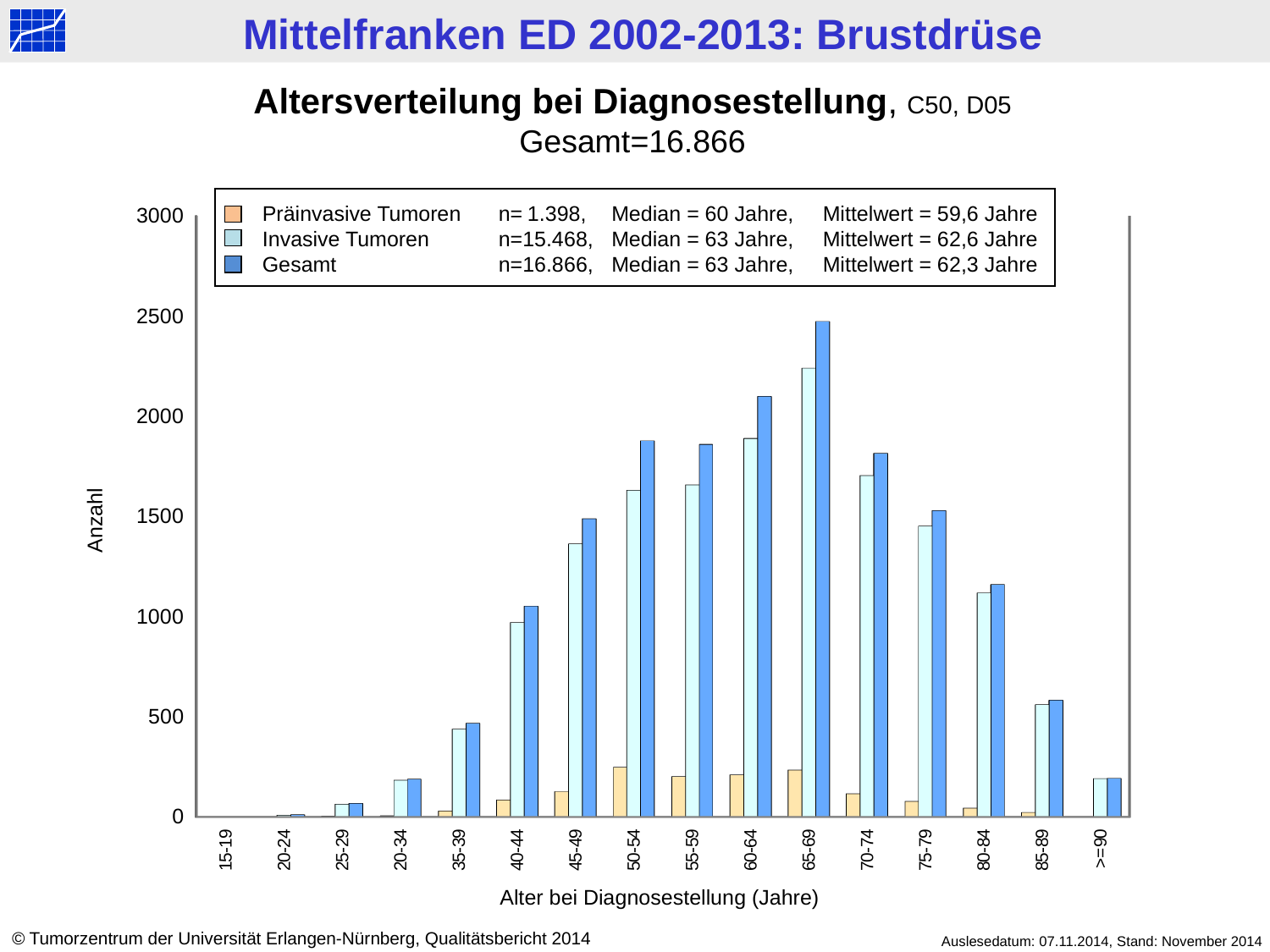
Is the Gesamt value for the 35-39 age group greater or less than 500? less According to the legend, what is the n for Präinvasive Tumoren? 1.398 Which age category has the highest value for the Gesamt series? 65-69 Is the Gesamt value for the 65-69 age group greater or less than 2000? greater Is the Invasive Tumoren value for the 50-54 age group greater or less than 1500? greater What kind of chart is shown on the slide? bar chart How many series does the legend list? 3 Which age category has the highest value for the Invasive Tumoren series? 65-69 What is the label of the x axis? Alter bei Diagnosestellung (Jahre) How many age categories are shown on the x axis? 16 Do the Gesamt values rise or fall from the 65-69 age group to the >=90 age group? fall Which is larger for the 60-64 age group: Präinvasive Tumoren or Invasive Tumoren? Invasive Tumoren